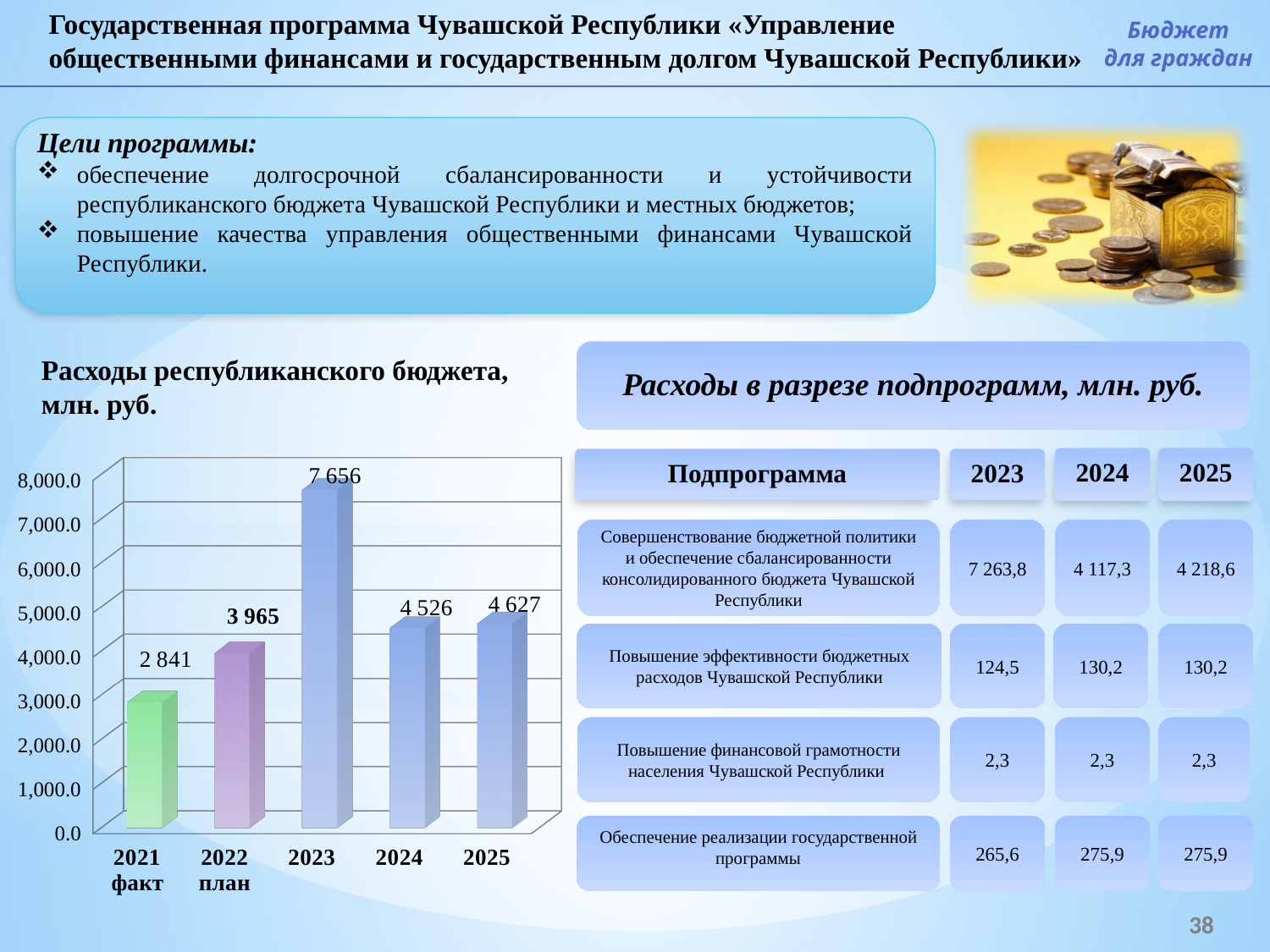
In the chart "Расходы республиканского бюджета, млн. руб.", which is larger: the value for 2023 or the value for 2025? 2023 In the chart "Расходы республиканского бюджета, млн. руб.", what is the difference between the values for 2023 and 2024? 3 130 In the chart "Расходы республиканского бюджета, млн. руб.", what is the difference between the values for 2022 план and 2021 факт? 1 124 What is the value for 2023 in the chart "Расходы республиканского бюджета, млн. руб."? 7 656 What type of chart is shown under the heading "Расходы республиканского бюджета, млн. руб."? bar chart In the chart "Расходы республиканского бюджета, млн. руб.", is the value for 2024 greater or less than 4,000.0? greater What is the value for 2025 in the chart "Расходы республиканского бюджета, млн. руб."? 4 627 How many bars are plotted in the chart "Расходы республиканского бюджета, млн. руб."? 5 What is the value for 2022 план in the chart "Расходы республиканского бюджета, млн. руб."? 3 965 What is the value for 2021 факт in the chart "Расходы республиканского бюджета, млн. руб."? 2 841 Which year has the highest value in the chart "Расходы республиканского бюджета, млн. руб."? 2023 Which category has the lowest value in the chart "Расходы республиканского бюджета, млн. руб."? 2021 факт